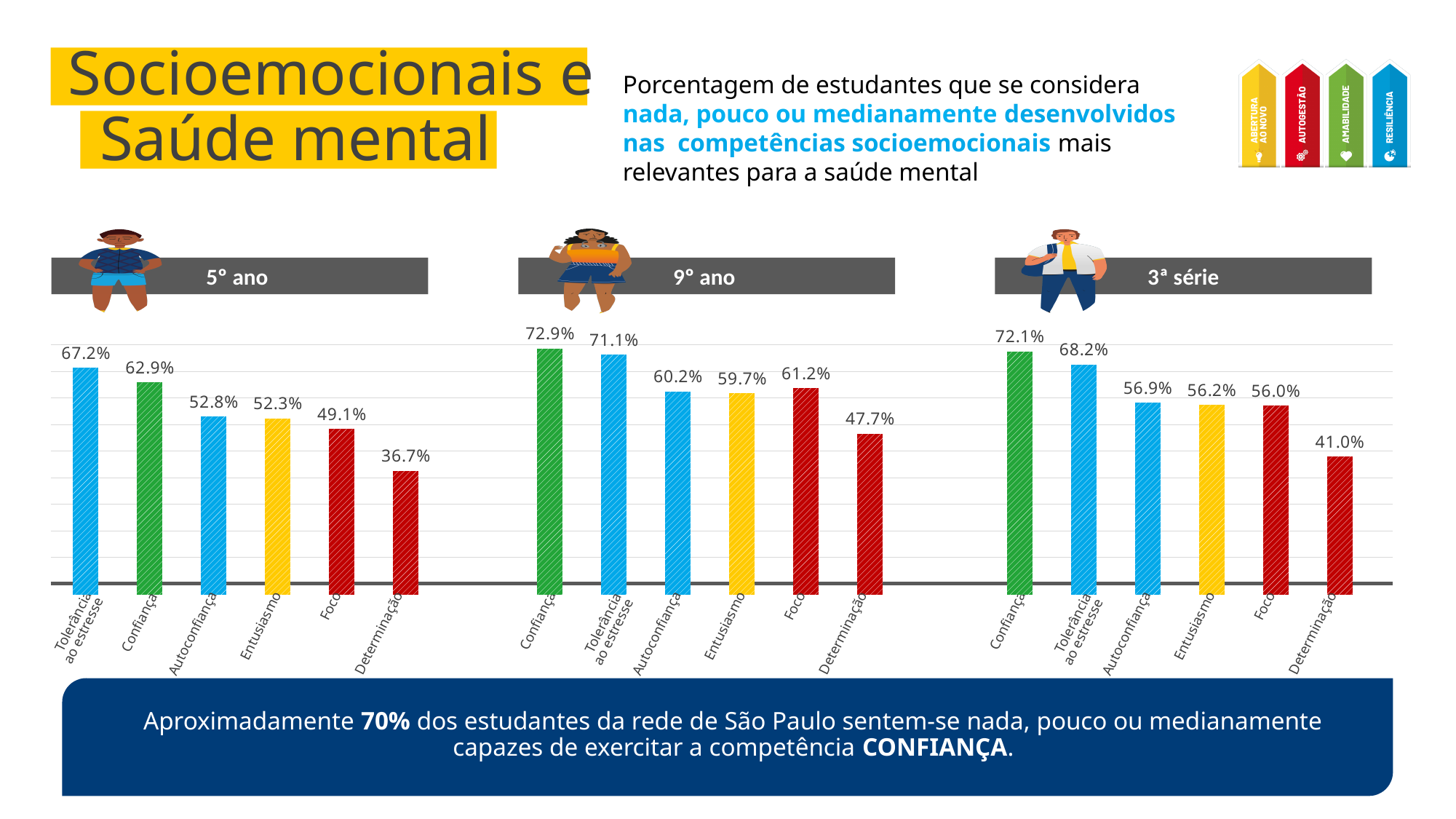
In the 9° ano chart, what is the value for Foco? 61.2% In the 3ª série chart, what is the value for Determinação? 41.0% How many categories are shown in the 9° ano chart? 6 In the 9° ano chart, which is larger, Autoconfiança or Determinação? Autoconfiança In the 5° ano chart, what is the value for Tolerância ao estresse? 67.2% In the 5° ano chart, what is the difference between Tolerância ao estresse and Determinação? 30.5% In the 5° ano chart, which category has the lowest value? Determinação In the 3ª série chart, what is the difference between Confiança and Tolerância ao estresse? 3.9% In the 9° ano chart, which category has the highest value? Confiança In the 3ª série chart, which category has the highest value? Confiança What type of chart is used for the 5° ano data? Bar chart How many separate charts are shown on the slide? 3